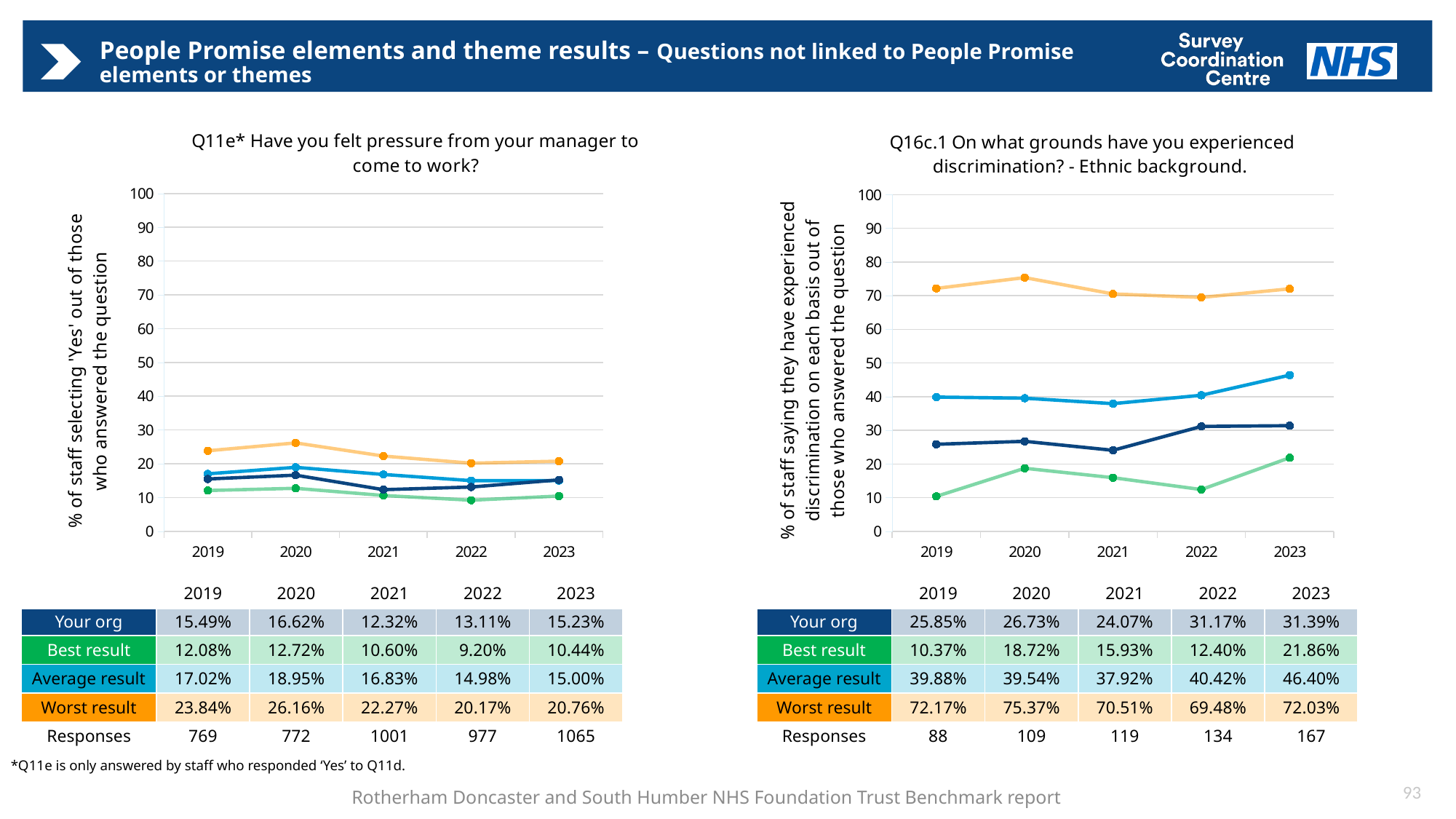
What kind of chart is the Q11e chart? Line chart In the Q16c.1 chart, how many responses were recorded for 2023? 167 In the Q16c.1 chart, what is the difference between the 'Average result' and 'Your org' values for 2023? 15.01% In the Q11e chart, in which year is the 'Best result' value lowest? 2022 In the Q11e chart, what is the 'Your org' value for 2021? 12.32% In the Q16c.1 chart, in which year is the 'Your org' value highest? 2023 How many series are shown in the Q16c.1 chart? 4 In the Q11e chart, does the 'Worst result' line rise or fall from 2020 to 2022? Fall In the Q11e chart, which is larger in 2020: the 'Your org' value or the 'Average result' value? Average result How many years are plotted on the x axis of the Q11e chart? 5 In the Q16c.1 chart, is the 'Worst result' value for 2021 greater or less than 60? greater In the Q16c.1 chart, what is the 'Worst result' value for 2020? 75.37%